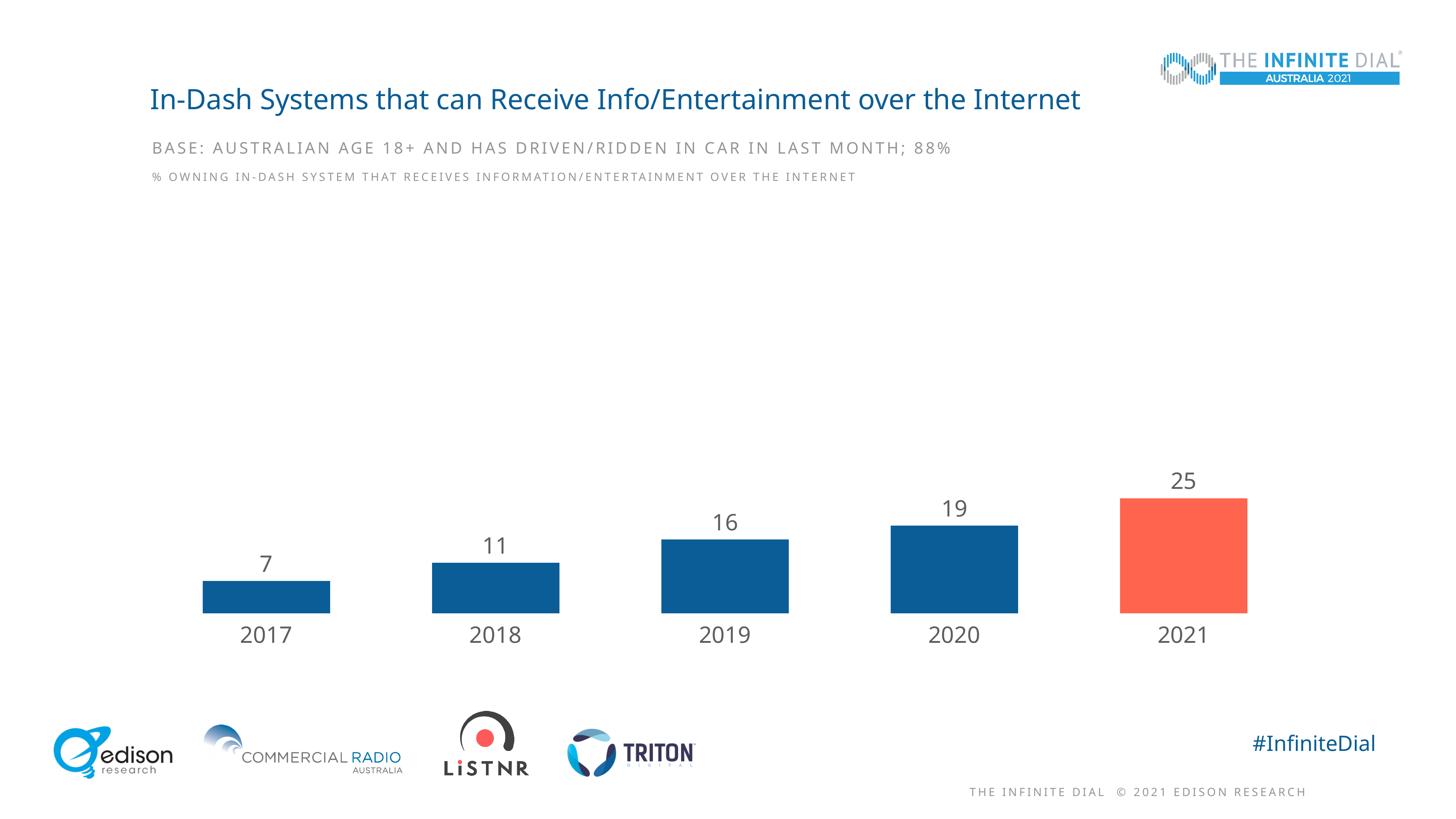
What is the value for 2017? 7 Which is larger, the value for 2018 or the value for 2020? 2020 Which year has the lowest value? 2017 Do the values rise or fall from 2017 to 2021? rise What is the difference between the values for 2020 and 2018? 8 What kind of chart is shown on the slide? bar chart Which year has the highest value? 2021 What is the difference between the values for 2021 and 2017? 18 How many years are shown on the chart? 5 Which year's bar is coloured differently from the others? 2021 What is the value for 2021? 25 What is the value for 2019? 16